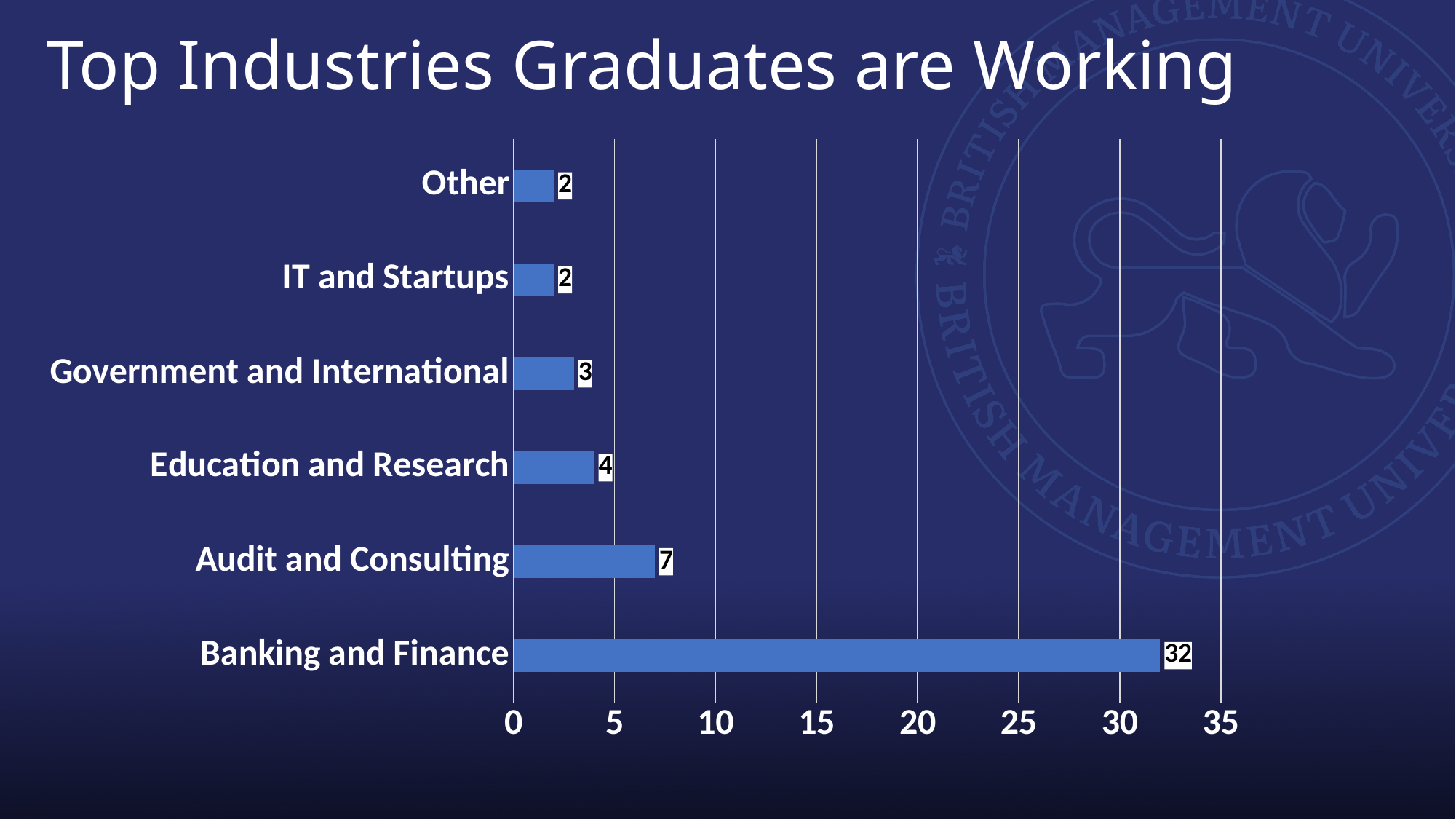
Is the value for Banking and Finance greater or less than 30? greater What is the value for Education and Research? 4 What is the value for Government and International? 3 What is the title of the slide? Top Industries Graduates are Working How many categories are shown in the chart? 6 What is the value for Banking and Finance? 32 Which is larger, the value for Education and Research or the value for Government and International? Education and Research Which category has the highest value? Banking and Finance What is the difference between the values for Audit and Consulting and Education and Research? 3 What is the difference between the values for Banking and Finance and Audit and Consulting? 25 What is the value for Audit and Consulting? 7 What kind of chart is shown on the slide? Bar chart